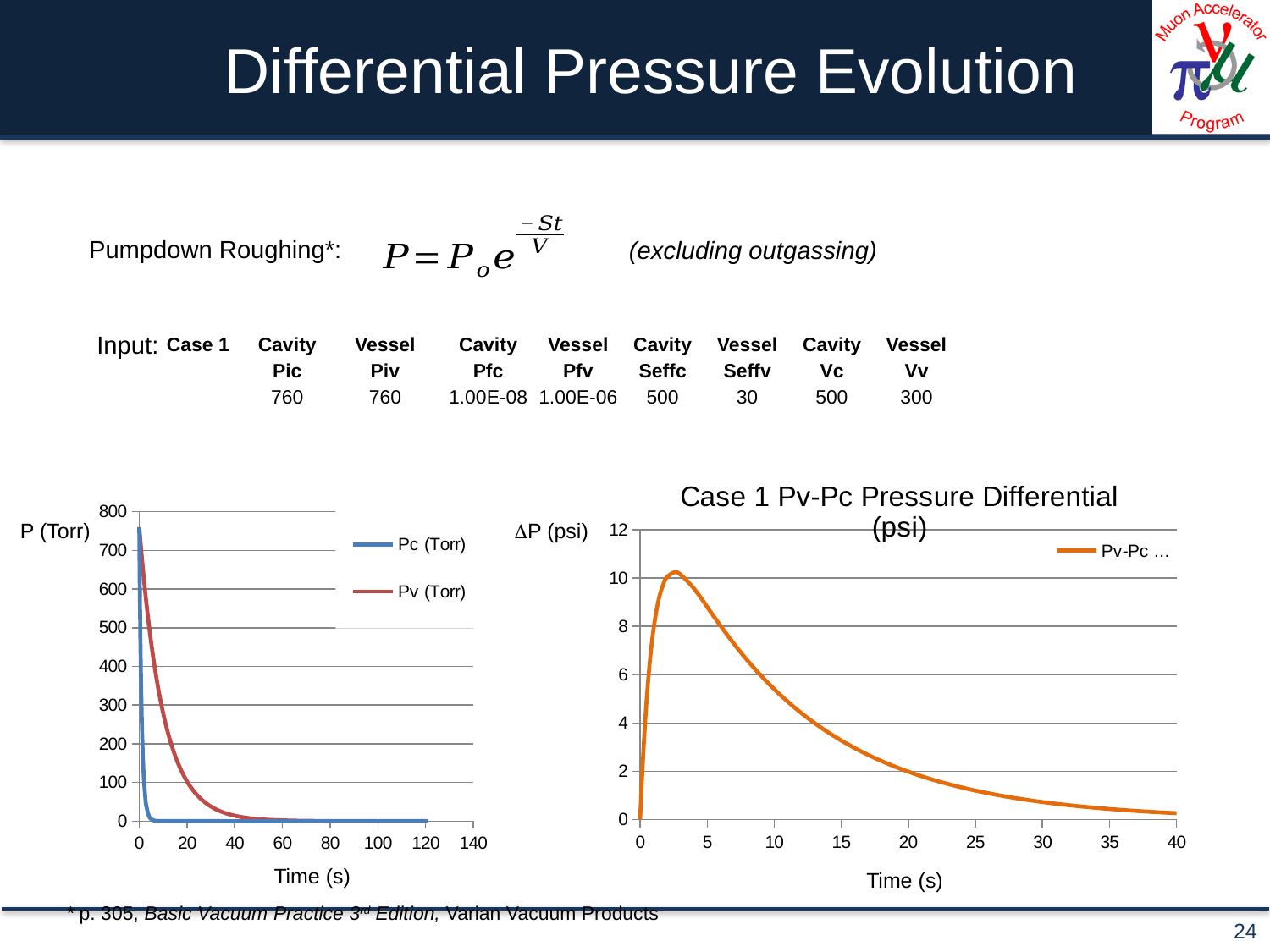
What are the two series named in the legend of the left chart? Pc (Torr) and Pv (Torr) In the right chart, is the peak value of Pv-Pc greater or less than 8? greater In the left chart, is the value of Pc (Torr) at time 20 s greater or less than 100? less How many series does the legend of the right chart list? 1 In the left chart, do the Pc (Torr) and Pv (Torr) values rise or fall as time increases? fall What is the title of the right chart? Case 1 Pv-Pc Pressure Differential (psi) In the right chart, after its peak, does the Pv-Pc curve rise or fall as time increases? fall In the right chart, is the value of Pv-Pc at time 20 s greater or less than 4? less In the left chart, at time 20 s, which series has the larger value, Pc (Torr) or Pv (Torr)? Pv (Torr) How many series does the legend of the left chart list? 2 What kind of chart is the left chart with the P (Torr) axis? line chart